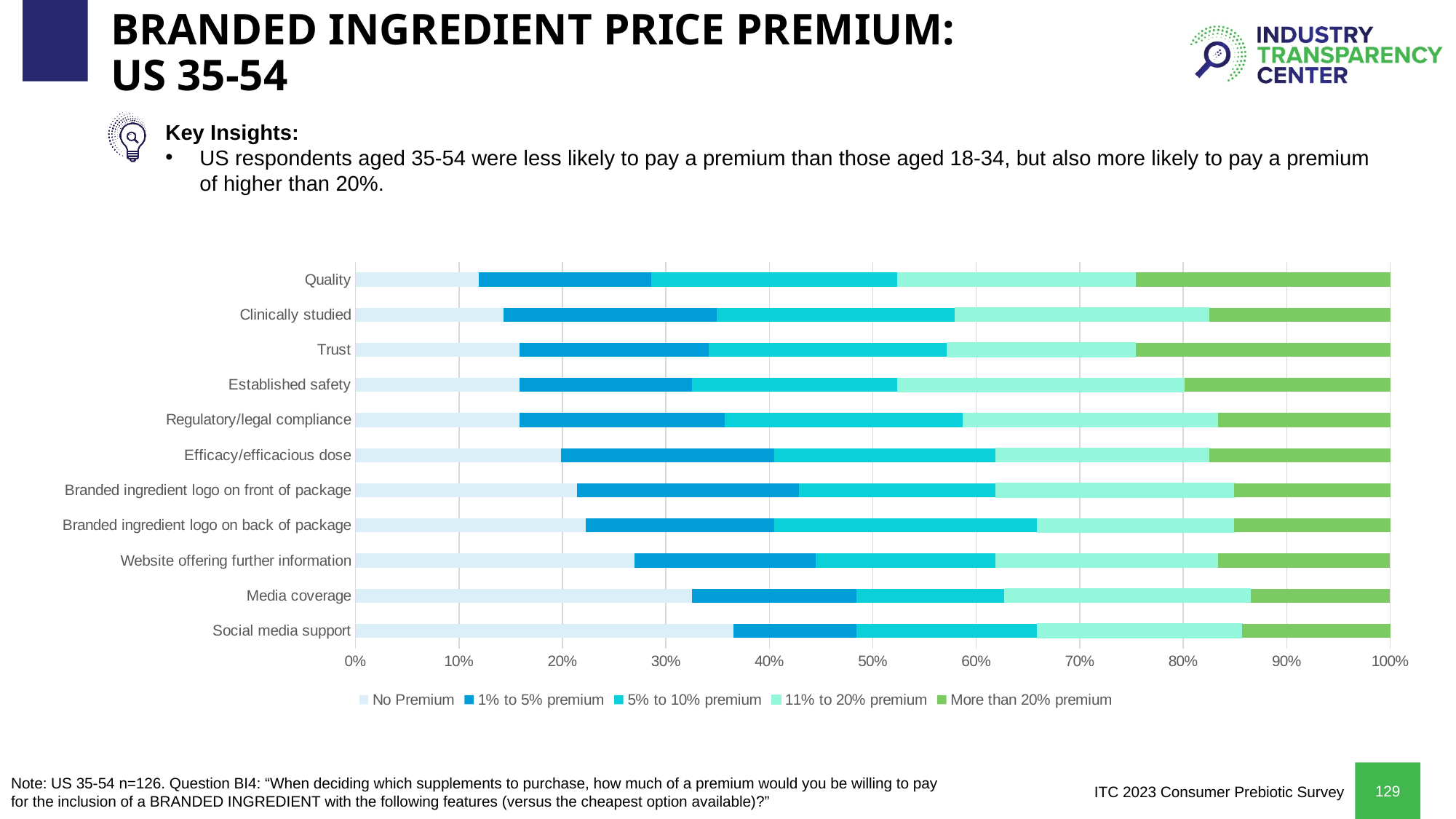
How many categories (features) are listed on the vertical axis of the chart? 11 Is the 'No Premium' share for Social media support greater or less than 30%? greater Which category has the smallest 'No Premium' share? Quality What is the first series listed in the chart legend? No Premium How many series does the chart legend list? 5 What colour represents the 'More than 20% premium' series in the chart? Green What kind of chart is shown on the slide? Stacked bar chart Which has the larger 'No Premium' share: Website offering further information or Efficacy/efficacious dose? Website offering further information Is the 'No Premium' share for Quality greater or less than 20%? less Which category has the largest 'No Premium' share? Social media support Is the 'No Premium' share for Media coverage greater or less than 30%? greater